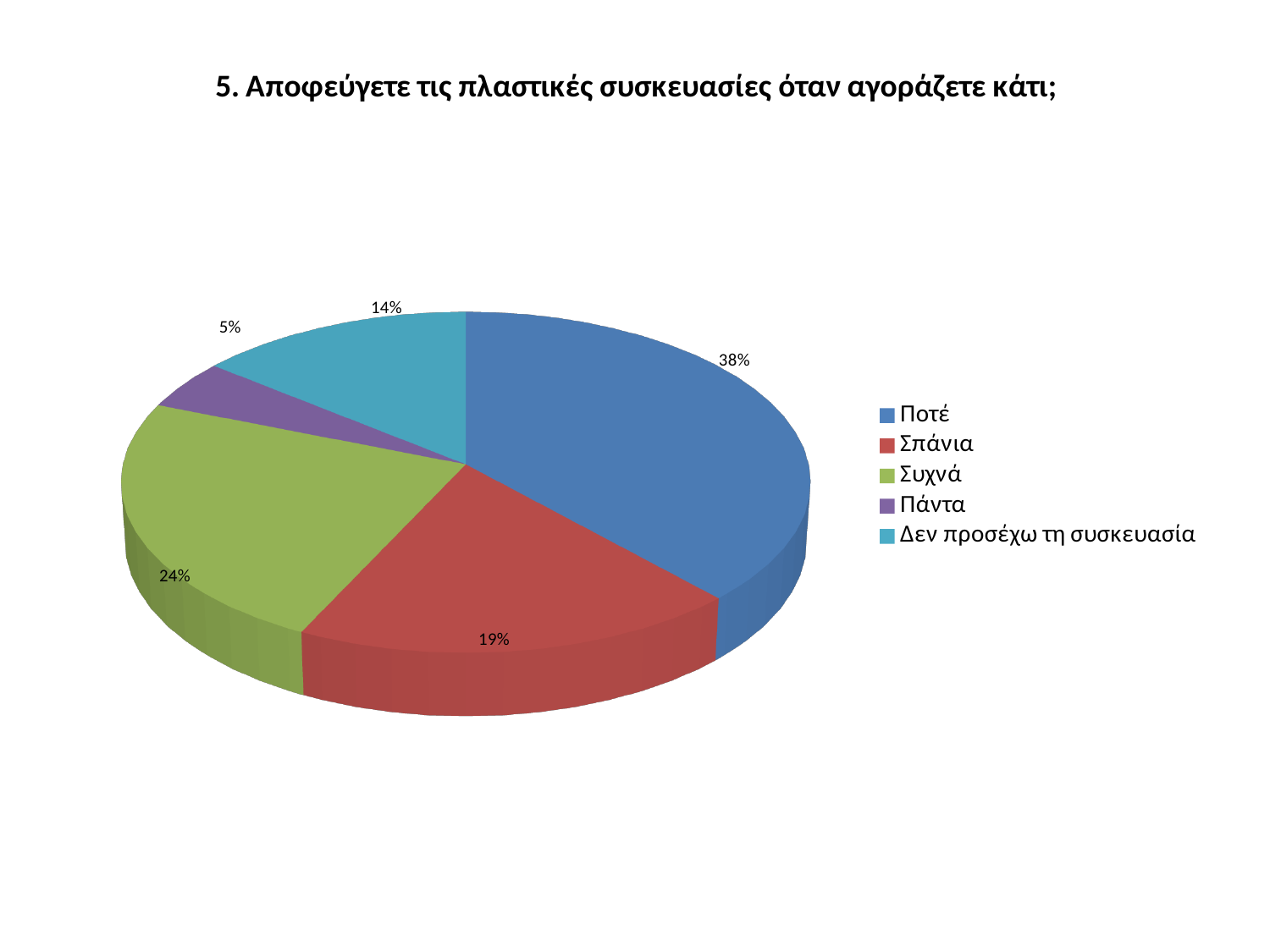
What percentage of the pie is the 'Ποτέ' slice? 38% Which category has the smallest share of the pie? Πάντα What percentage of the pie is the 'Συχνά' slice? 24% What percentage of the pie is the 'Σπάνια' slice? 19% What percentage of the pie is the 'Πάντα' slice? 5% What type of chart is shown on the slide? Pie chart How many categories does the legend list? 5 Which category has the largest share of the pie? Ποτέ What percentage of the pie is the 'Δεν προσέχω τη συσκευασία' slice? 14% What is the title of the chart? 5. Αποφεύγετε τις πλαστικές συσκευασίες όταν αγοράζετε κάτι; Which is larger, the 'Σπάνια' slice or the 'Δεν προσέχω τη συσκευασία' slice? Σπάνια What is the difference in percentage points between the 'Ποτέ' and 'Συχνά' slices? 14